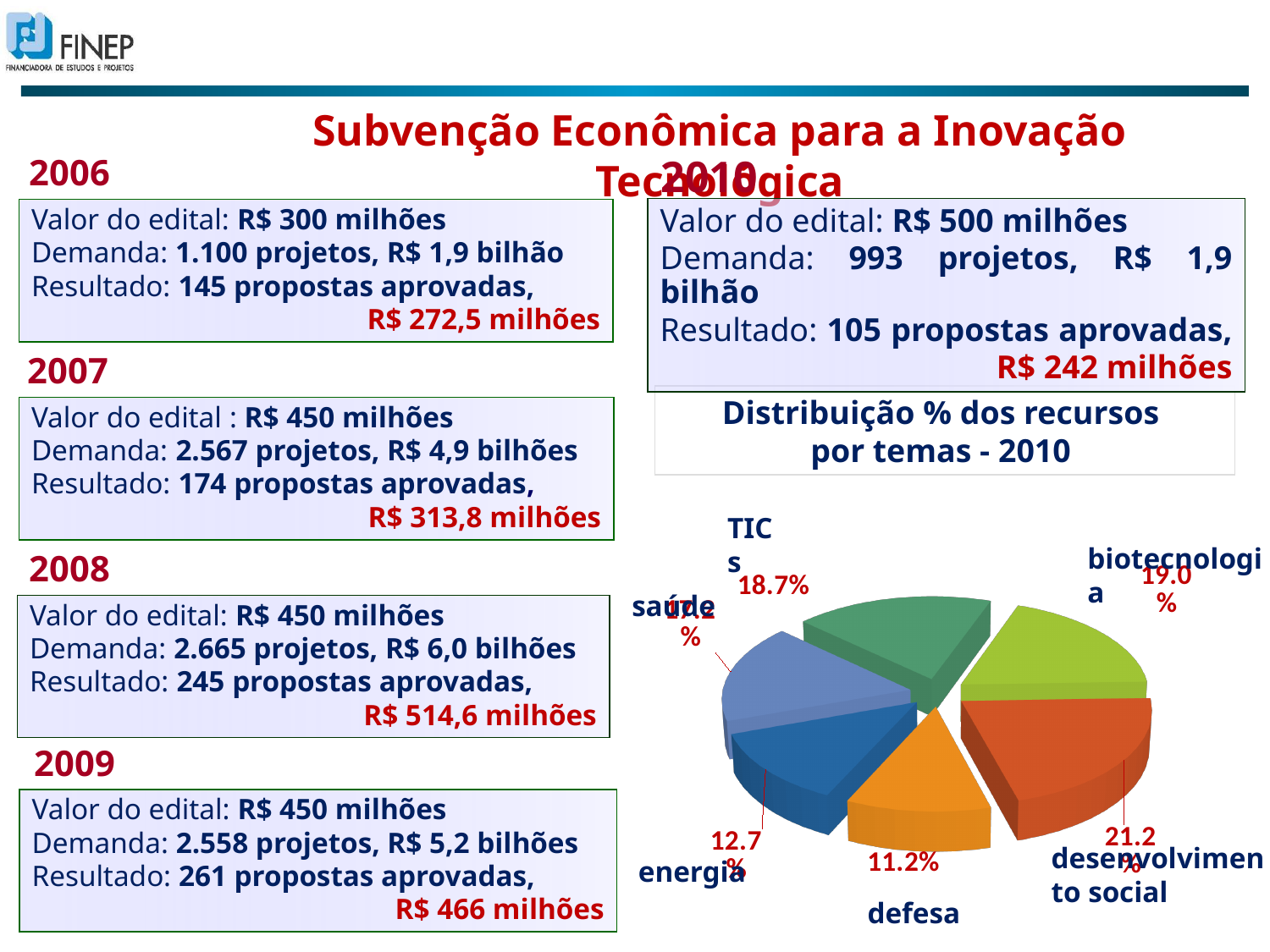
What percentage of the resources went to desenvolvimento social in the pie chart? 21.2% Which theme received the smallest share of resources in the pie chart? defesa What percentage of the resources went to defesa in the pie chart? 11.2% How many themes (slices) are shown in the pie chart? 6 Which theme received the largest share of resources in the pie chart? desenvolvimento social What is the title of the pie chart? Distribuição % dos recursos por temas - 2010 What kind of chart is shown on the slide? Pie chart What percentage of the resources went to TICs in the pie chart? 18.7% How many percentage points larger is the desenvolvimento social share than the defesa share? 10.0 percentage points What percentage of the resources went to energia in the pie chart? 12.7% What percentage of the resources went to biotecnologia in the pie chart? 19.0% Which received a larger share of resources, energia or defesa? energia